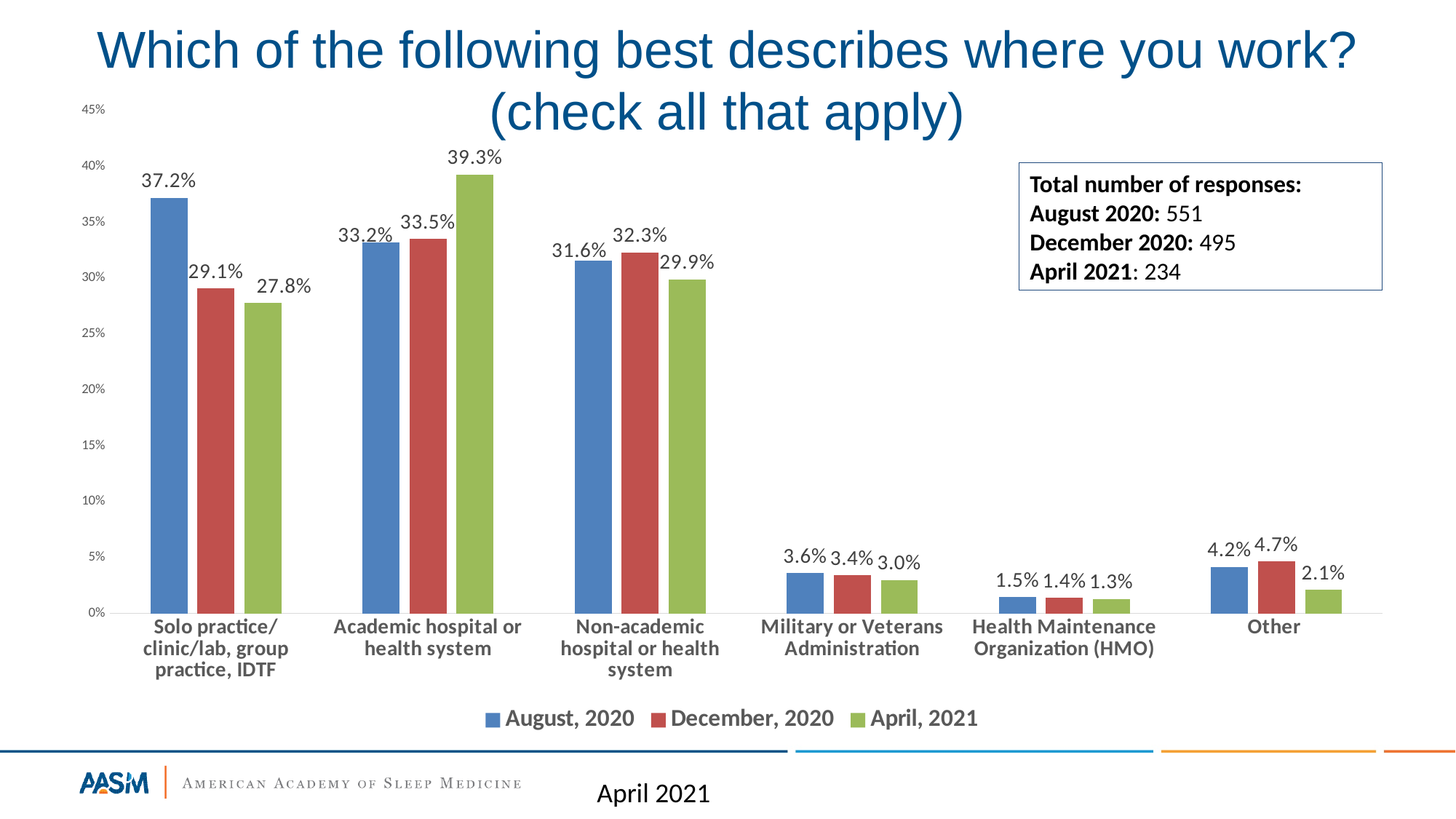
What is the value for Academic hospital or health system in April, 2021? 39.3% Which category has the highest value in the April, 2021 series? Academic hospital or health system Do the values for Military or Veterans Administration rise or fall from August, 2020 to April, 2021? Fall What kind of chart is shown on the slide? Bar chart What is the value for Solo practice/clinic/lab, group practice, IDTF in August, 2020? 37.2% Which is larger for Other: the December, 2020 value or the April, 2021 value? December, 2020 What is the value for Health Maintenance Organization (HMO) in April, 2021? 1.3% How many categories are shown on the x axis? 6 Which category has the lowest value in the August, 2020 series? Health Maintenance Organization (HMO) What is the difference between the August, 2020 and April, 2021 values for Solo practice/clinic/lab, group practice, IDTF? 9.4% What is the value for Non-academic hospital or health system in December, 2020? 32.3% How many series does the legend list? 3